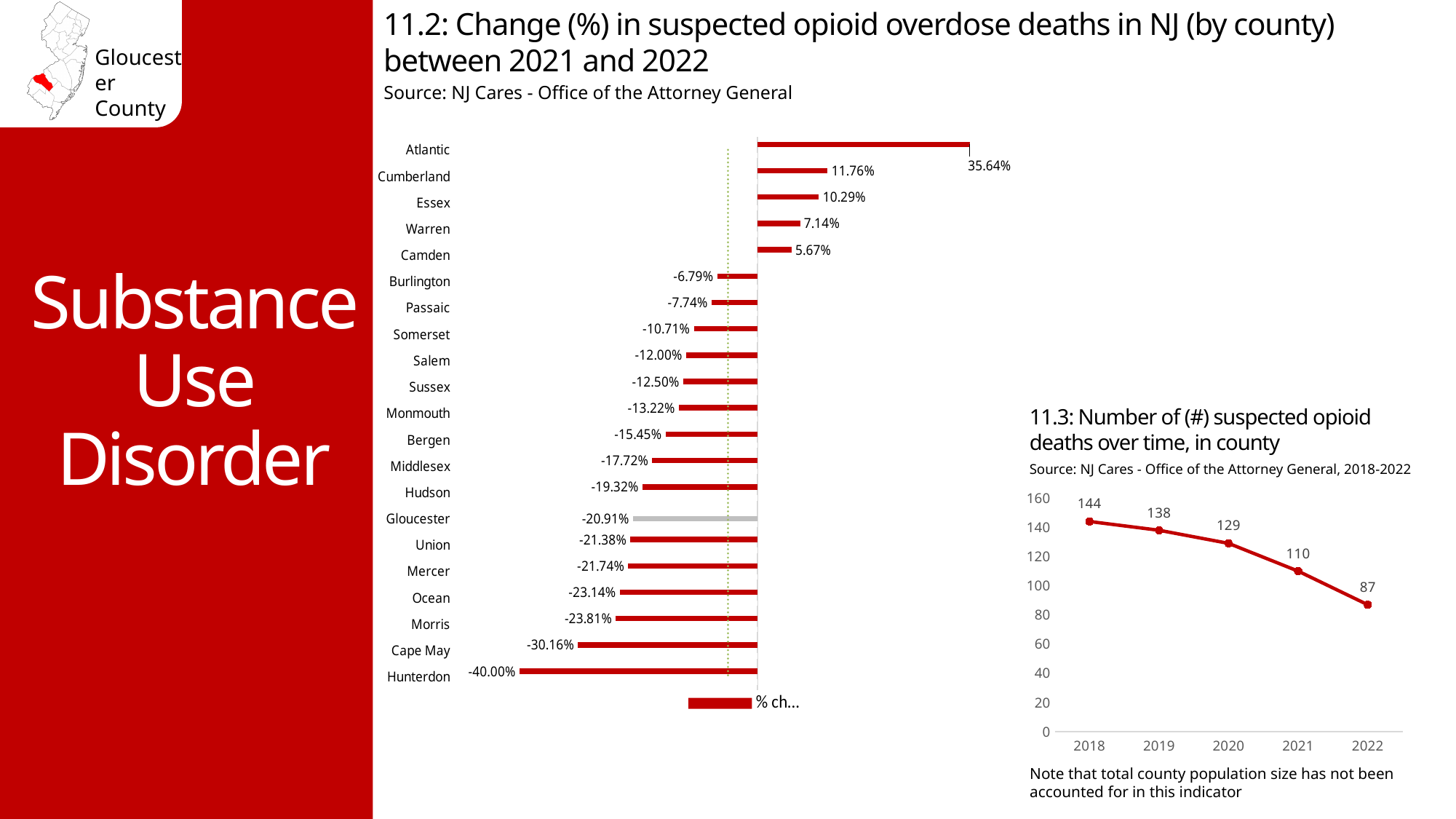
What kind of chart is '11.3: Number of (#) suspected opioid deaths over time, in county'? Line chart In the chart '11.3: Number of (#) suspected opioid deaths over time, in county', do the values rise or fall from 2018 to 2022? Fall In the chart '11.2: Change (%) in suspected opioid overdose deaths in NJ (by county) between 2021 and 2022', which has the larger value, Cape May or Morris? Morris What kind of chart is '11.2: Change (%) in suspected opioid overdose deaths in NJ (by county) between 2021 and 2022'? Bar chart In the chart '11.3: Number of (#) suspected opioid deaths over time, in county', what is the value for 2020? 129 In the chart '11.2: Change (%) in suspected opioid overdose deaths in NJ (by county) between 2021 and 2022', which county has the lowest value? Hunterdon In the chart '11.2: Change (%) in suspected opioid overdose deaths in NJ (by county) between 2021 and 2022', what is the value for Gloucester? -20.91% In the chart '11.2: Change (%) in suspected opioid overdose deaths in NJ (by county) between 2021 and 2022', which county has the highest value? Atlantic In the chart '11.2: Change (%) in suspected opioid overdose deaths in NJ (by county) between 2021 and 2022', what is the difference in percentage points between Atlantic and Cumberland? 23.88 percentage points In the chart '11.3: Number of (#) suspected opioid deaths over time, in county', what is the difference between the 2018 and 2022 values? 57 In the chart '11.2: Change (%) in suspected opioid overdose deaths in NJ (by county) between 2021 and 2022', how many counties are shown? 21 In the chart '11.2: Change (%) in suspected opioid overdose deaths in NJ (by county) between 2021 and 2022', what is the value for Camden? 5.67%